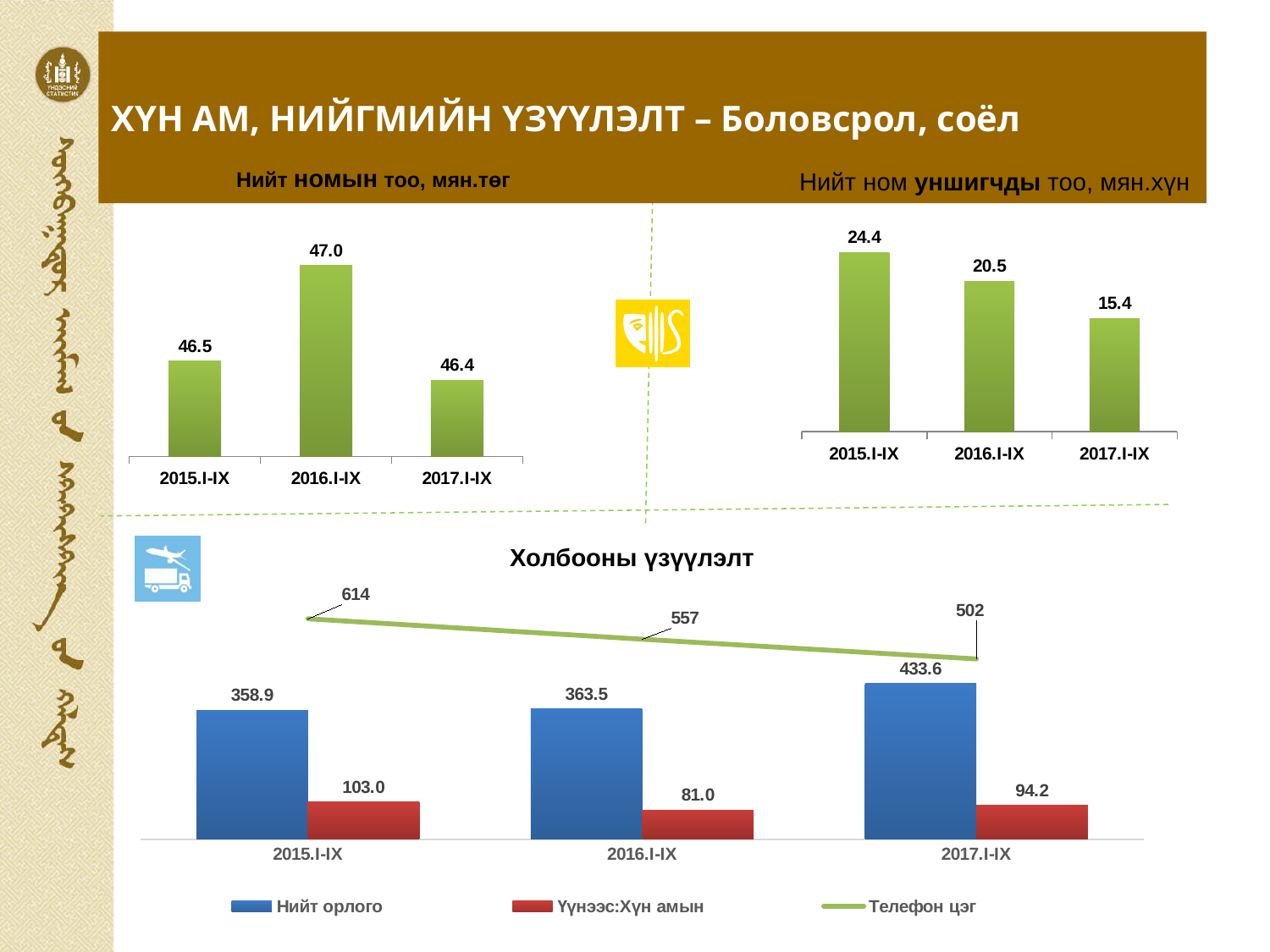
In the chart titled 'Нийт номын тоо, мян.төг', which period has the lowest value? 2017.I-IX In the chart titled 'Холбооны үзүүлэлт', how many series does the legend list? 3 In the chart titled 'Холбооны үзүүлэлт', what is the value of 'Телефон цэг' for 2016.I-IX? 557 In the chart titled 'Нийт ном уншигчды тоо, мян.хүн', how many periods are shown? 3 In the chart titled 'Нийт номын тоо, мян.төг', what is the value for 2016.I-IX? 47.0 In the chart titled 'Холбооны үзүүлэлт', which series is drawn as a line rather than bars? Телефон цэг In the chart titled 'Холбооны үзүүлэлт', what is the difference between 'Нийт орлого' for 2017.I-IX and 2016.I-IX? 70.1 In the chart titled 'Нийт ном уншигчды тоо, мян.хүн', what is the difference between the 2015.I-IX and 2017.I-IX values? 9.0 In the chart titled 'Холбооны үзүүлэлт', which period has the highest value of 'Үүнээс:Хүн амын'? 2015.I-IX In the chart titled 'Холбооны үзүүлэлт', what is the value of 'Нийт орлого' for 2017.I-IX? 433.6 In the chart titled 'Нийт ном уншигчды тоо, мян.хүн', do the values rise or fall from 2015.I-IX to 2017.I-IX? fall In the chart titled 'Нийт ном уншигчды тоо, мян.хүн', what is the value for 2015.I-IX? 24.4